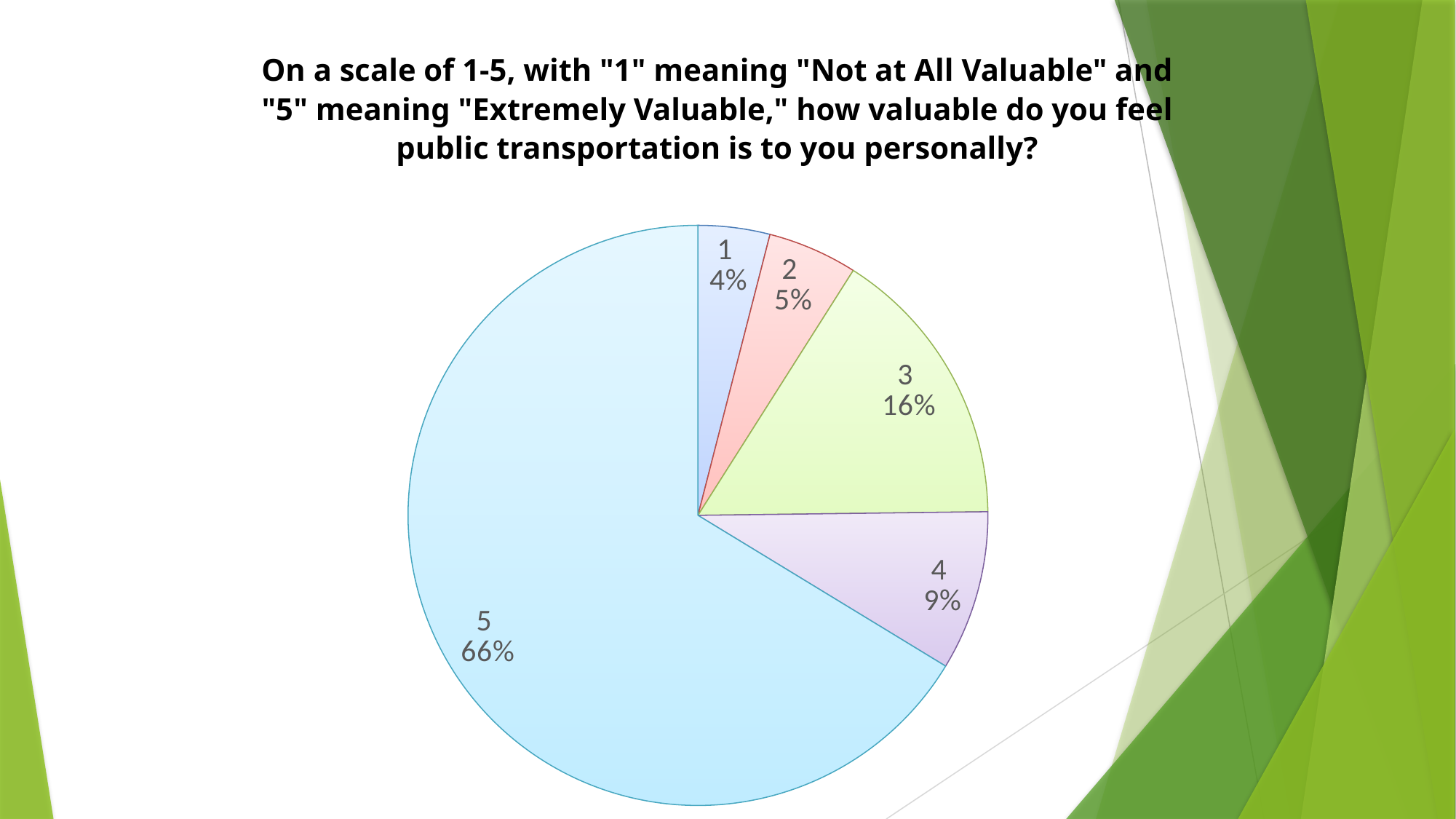
Which rating has the largest slice of the pie? 5 How many slices does the pie chart have? 5 What share of respondents rated public transportation a 3? 16% What is the combined share of ratings 1 and 2? 9% Which is larger, the share for rating 2 or the share for rating 4? rating 4 What is the difference in percentage points between the share for rating 3 and the share for rating 4? 7 What kind of chart is shown on the slide? pie chart What share of respondents rated public transportation a 5? 66% What share of respondents rated public transportation a 4? 9% What share of respondents rated public transportation a 1? 4% What is the title of the chart? On a scale of 1-5, with "1" meaning "Not at All Valuable" and "5" meaning "Extremely Valuable," how valuable do you feel public transportation is to you personally? Which rating has the smallest slice of the pie? 1